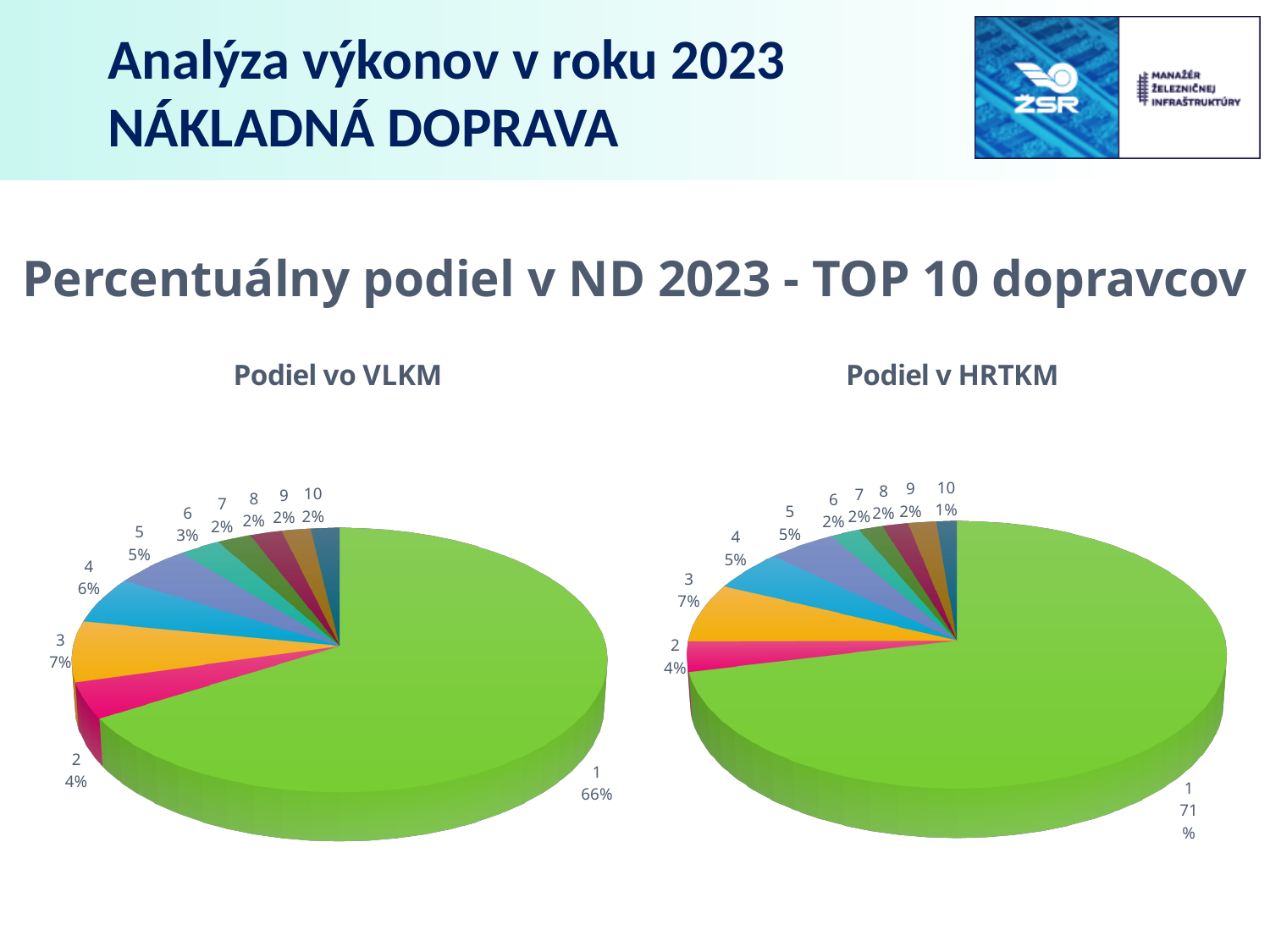
In the "Podiel vo VLKM" chart, which category has the largest share? 1 How many categories are shown in the "Podiel v HRTKM" chart? 10 What is the title of the chart on the right side of the slide? Podiel v HRTKM In the "Podiel v HRTKM" chart, what share does category 1 have? 71% In the "Podiel vo VLKM" chart, what is the share of category 3? 7% In the "Podiel vo VLKM" chart, what share does category 1 have? 66% In the "Podiel vo VLKM" chart, which has a larger share, category 4 or category 5? 4 In the "Podiel v HRTKM" chart, which category has the smallest share? 10 What is the difference between the share of category 1 in the "Podiel v HRTKM" chart and the share of category 1 in the "Podiel vo VLKM" chart? 5% What type of chart is "Podiel vo VLKM"? Pie chart In the "Podiel vo VLKM" chart, what is the difference between the shares of category 3 and category 2? 3% In the "Podiel v HRTKM" chart, what is the share of category 10? 1%